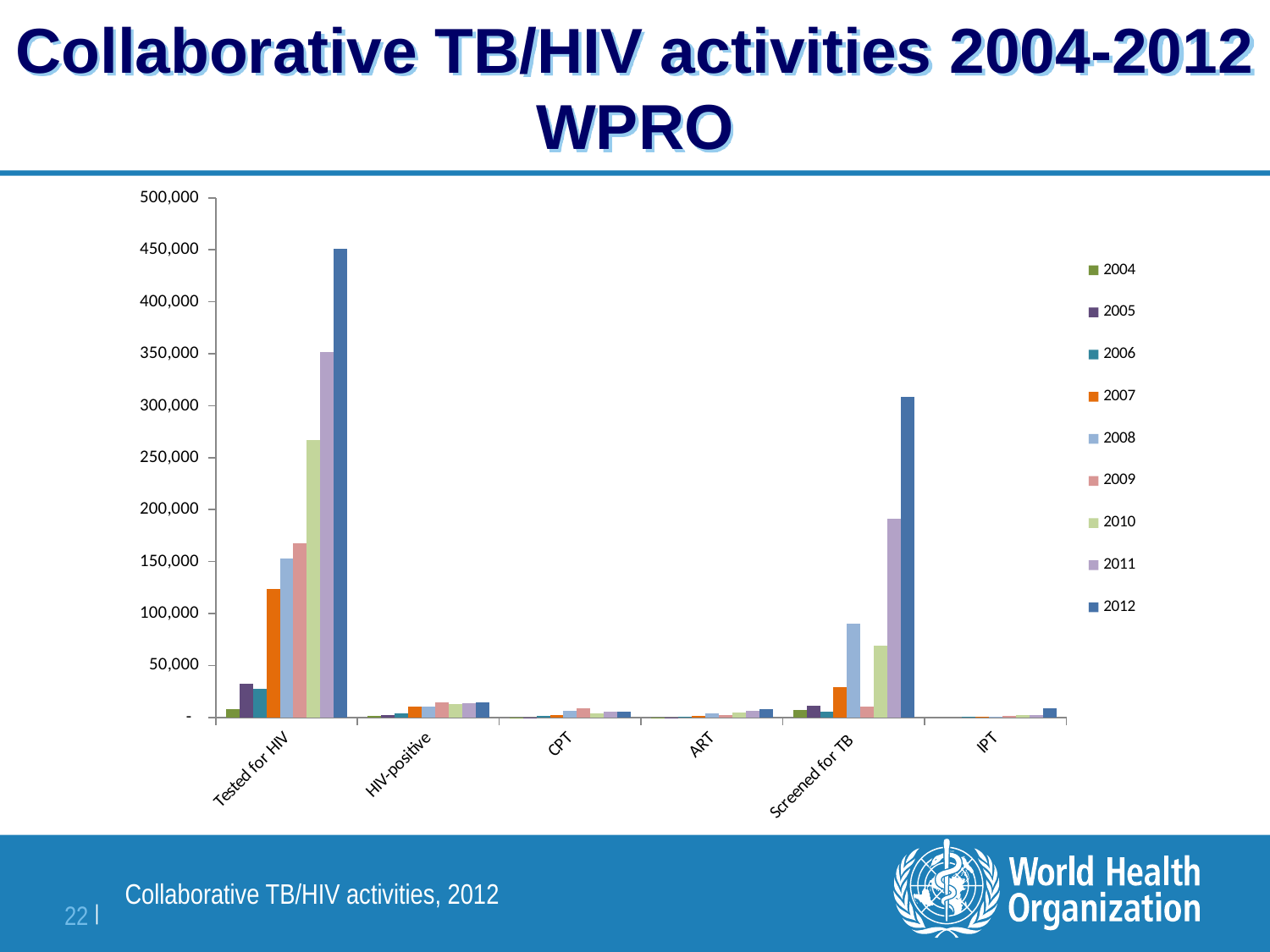
Is the value for Tested for HIV in 2012 greater or less than 400,000? greater What kind of chart is shown on the slide? bar chart Is the value for Screened for TB in 2008 greater or less than 100,000? less How many categories are shown on the x axis of the chart? 6 Is the value for Screened for TB in 2011 greater or less than 200,000? less How many series does the legend list? 9 Do the values for Tested for HIV rise or fall from 2004 to 2012? rise Which is larger in 2012: Tested for HIV or Screened for TB? Tested for HIV Which category has the tallest bar for 2012? Tested for HIV